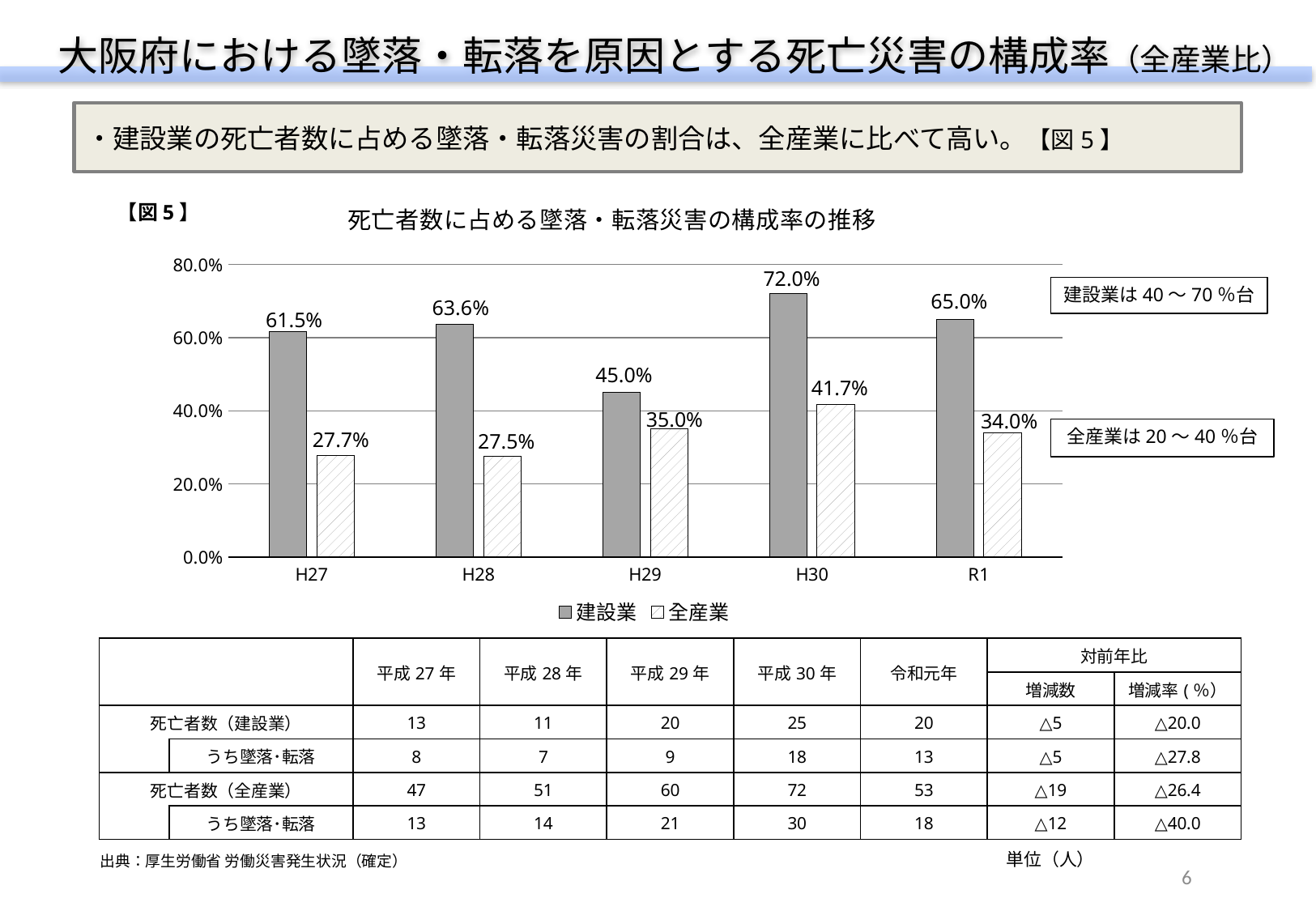
In which year is the 建設業 value highest? H30 In which year is the 建設業 value lowest? H29 What is the value for 建設業 in R1? 65.0% In which year is the 全産業 value highest? H30 How many series does the legend list? 2 Which is larger in H28, the 建設業 value or the 全産業 value? 建設業 How many years are shown on the x axis? 5 What kind of chart is shown? bar chart What is the value for 建設業 in H30? 72.0% What is the difference between the 建設業 and 全産業 values in H27? 33.8% What is the title of the chart? 死亡者数に占める墜落・転落災害の構成率の推移 What is the value for 全産業 in H29? 35.0%